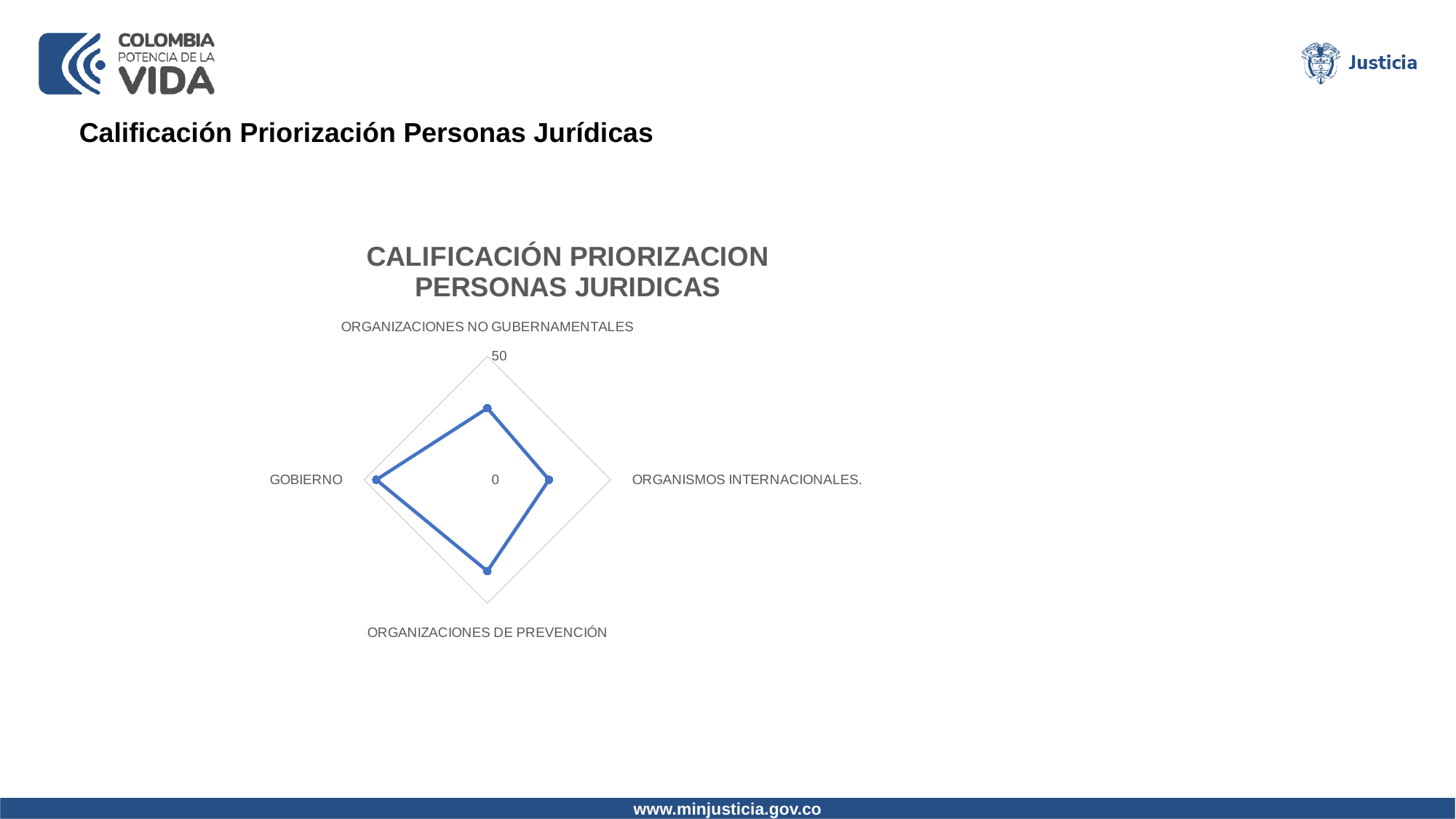
Is the value for ORGANISMOS INTERNACIONALES. greater or less than 50? less Which category has the highest value in the chart? GOBIERNO Is the value for ORGANIZACIONES NO GUBERNAMENTALES greater or less than 50? less Which has the larger value, ORGANIZACIONES DE PREVENCIÓN or ORGANIZACIONES NO GUBERNAMENTALES? ORGANIZACIONES DE PREVENCIÓN How many categories (axes) does the radar chart have? 4 Which category has the lowest value in the chart? ORGANISMOS INTERNACIONALES. Which has the larger value, GOBIERNO or ORGANISMOS INTERNACIONALES.? GOBIERNO Which has the larger value, ORGANIZACIONES DE PREVENCIÓN or ORGANISMOS INTERNACIONALES.? ORGANIZACIONES DE PREVENCIÓN What is the title of the chart? CALIFICACIÓN PRIORIZACION PERSONAS JURIDICAS What is the maximum value shown on the chart's axis scale? 50 What kind of chart is shown on the slide? Radar chart